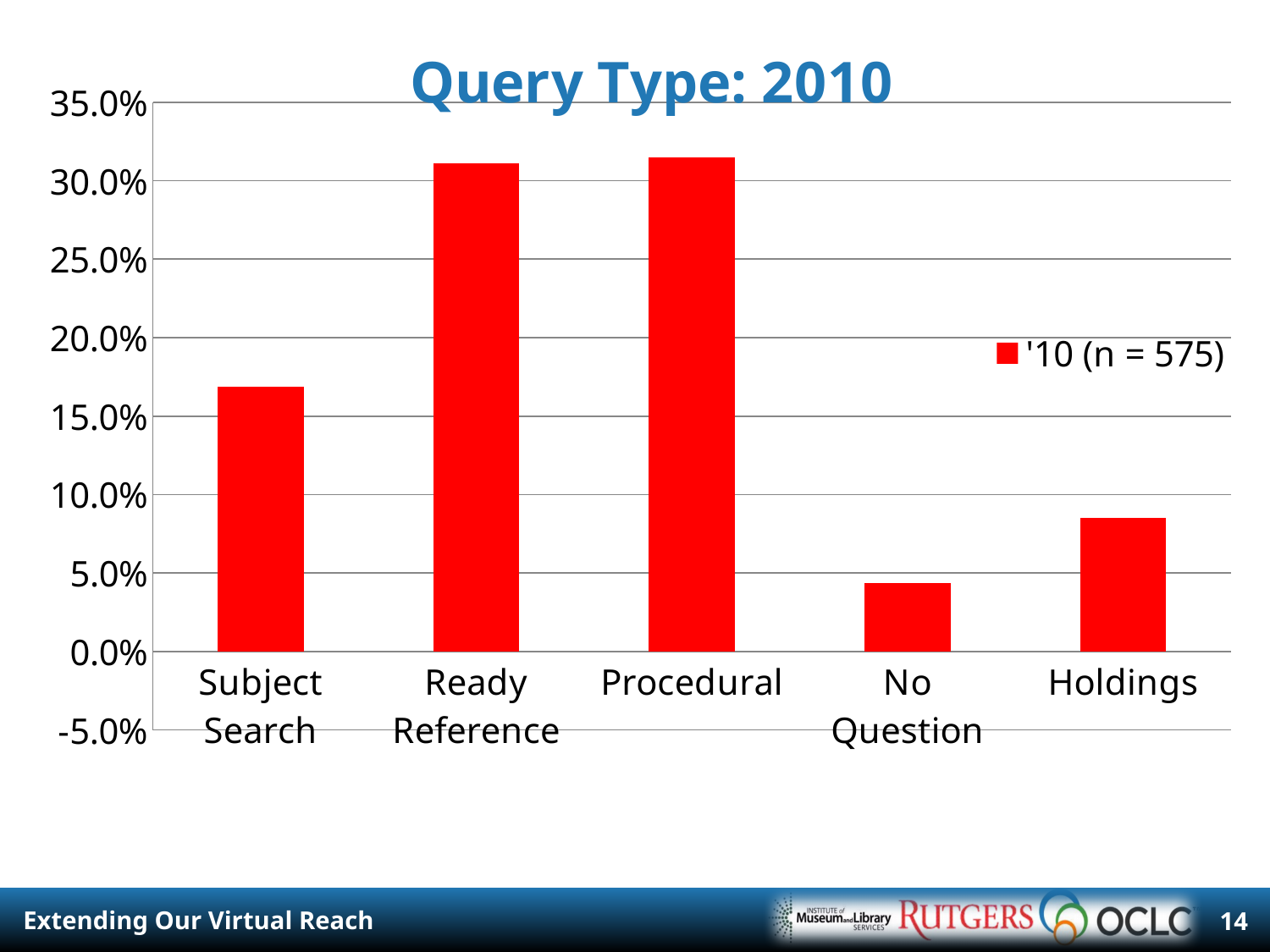
Is the value for Subject Search greater or less than 20.0%? less How many categories are shown on the x axis of the chart? 5 Is the value for Procedural greater or less than 30.0%? greater Is the value for Subject Search greater or less than 15.0%? greater What is the title of the chart? Query Type: 2010 Which category has the lowest value in the chart? No Question What is the legend entry for the series in the chart? '10 (n = 575) Which is larger, the value for Subject Search or the value for Holdings? Subject Search How many series does the legend list? 1 What kind of chart is shown on the slide? bar chart